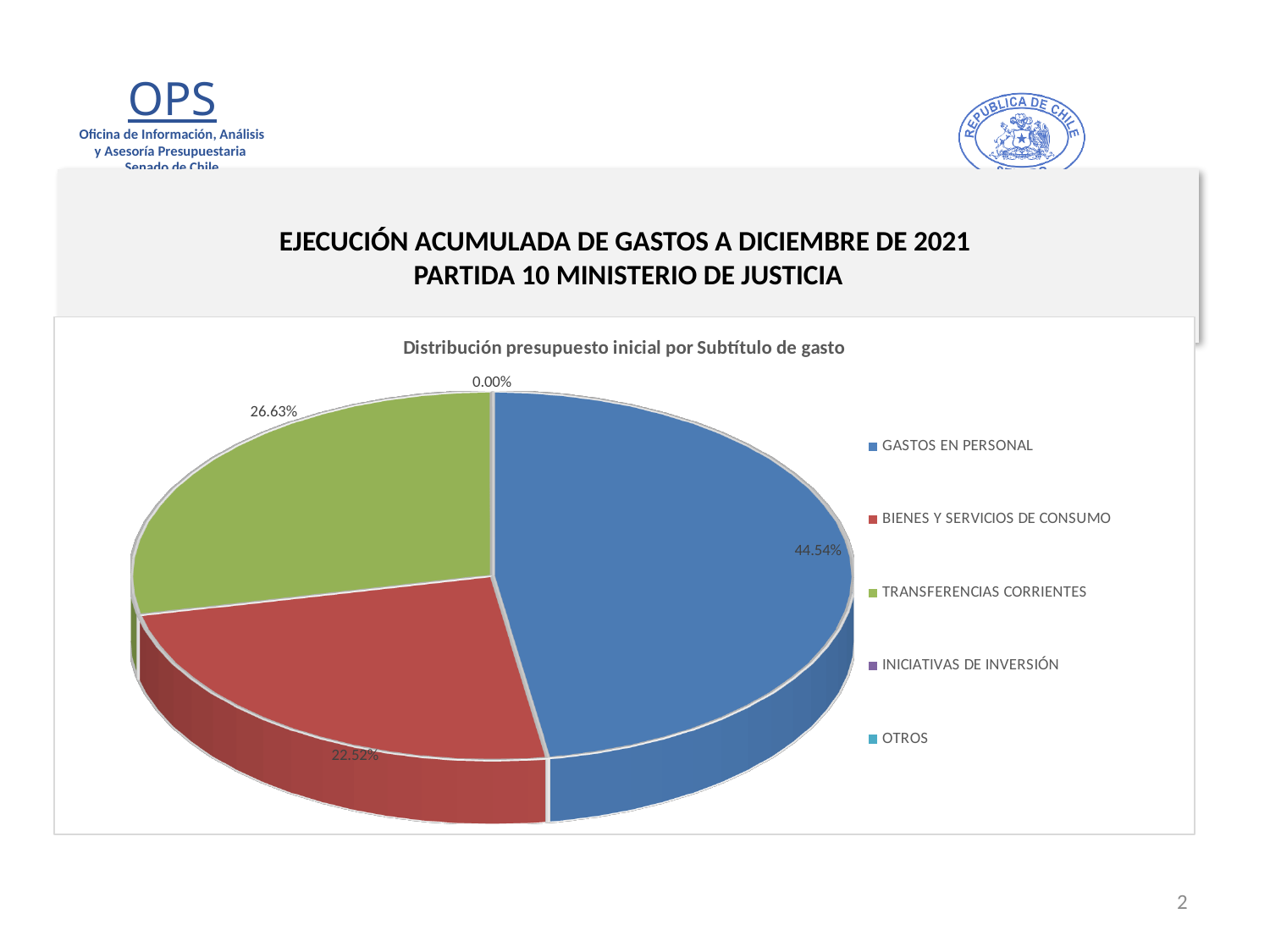
What percentage share does TRANSFERENCIAS CORRIENTES have in the pie chart? 26.63% By how many percentage points does GASTOS EN PERSONAL exceed BIENES Y SERVICIOS DE CONSUMO? 22.02 percentage points What type of chart is shown on the slide? Pie chart Which slice is larger, TRANSFERENCIAS CORRIENTES or BIENES Y SERVICIOS DE CONSUMO? TRANSFERENCIAS CORRIENTES Which category has the largest slice of the pie chart? GASTOS EN PERSONAL By how many percentage points does GASTOS EN PERSONAL exceed TRANSFERENCIAS CORRIENTES? 17.91 percentage points By how many percentage points does TRANSFERENCIAS CORRIENTES exceed BIENES Y SERVICIOS DE CONSUMO? 4.11 percentage points What percentage share does BIENES Y SERVICIOS DE CONSUMO have in the pie chart? 22.52% How many categories are listed in the chart's legend? 5 What percentage share does GASTOS EN PERSONAL have in the pie chart? 44.54% What colour represents GASTOS EN PERSONAL in the pie chart? Blue What is the title of the chart? Distribución presupuesto inicial por Subtítulo de gasto